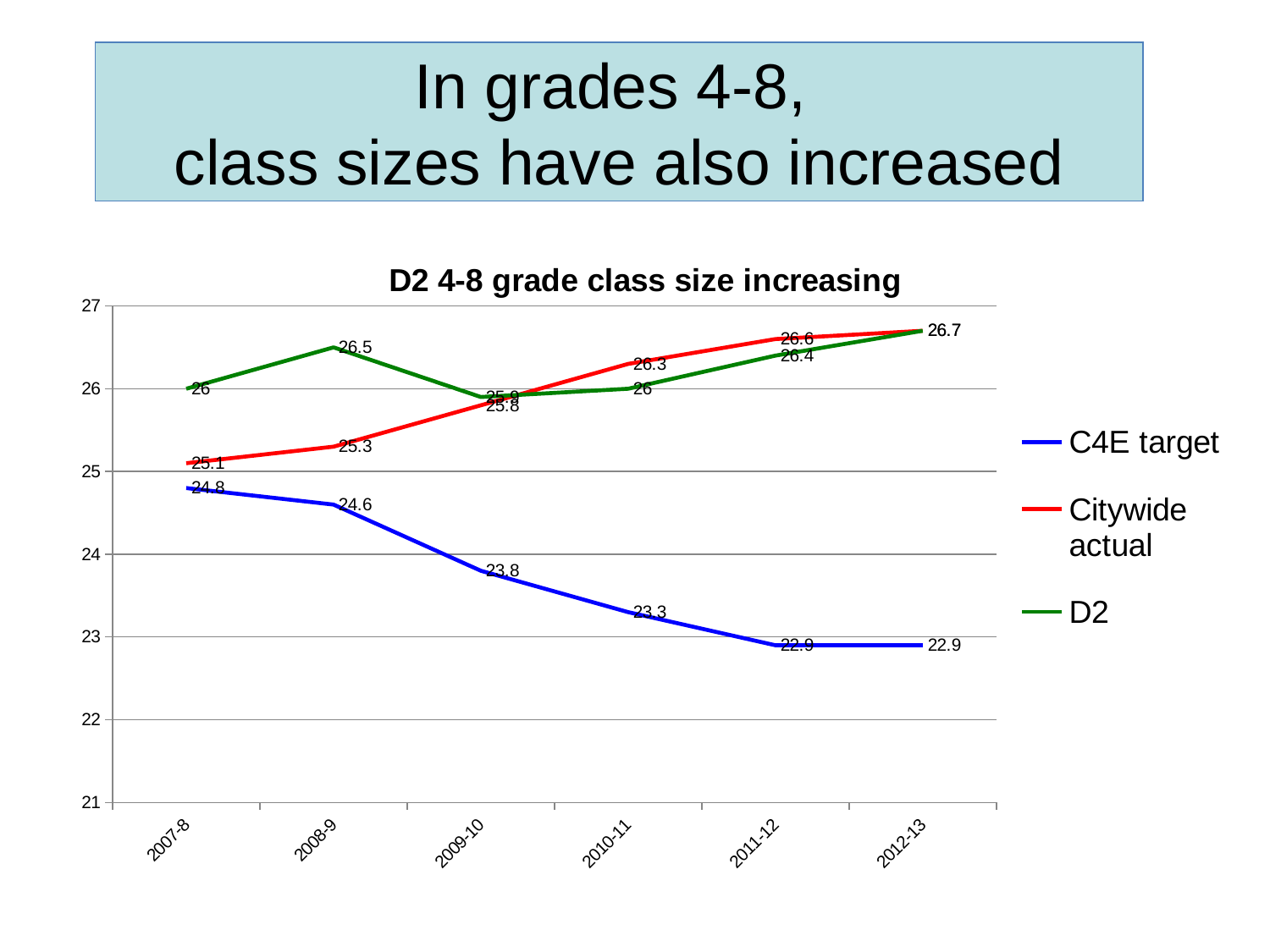
In which year is the Citywide actual value highest? 2012-13 What is the Citywide actual value for 2010-11? 26.3 What is the D2 value for 2008-9? 26.5 How many school years are shown on the x axis? 6 Does the C4E target rise or fall from 2007-8 to 2012-13? fall In 2008-9, which is larger: the D2 value or the Citywide actual value? D2 What is the difference between the C4E target in 2007-8 and in 2012-13? 1.9 What is the C4E target value for 2007-8? 24.8 How many series does the legend list? 3 In which year is the C4E target highest? 2007-8 What kind of chart is shown on the slide? line chart What is the title of the chart? D2 4-8 grade class size increasing